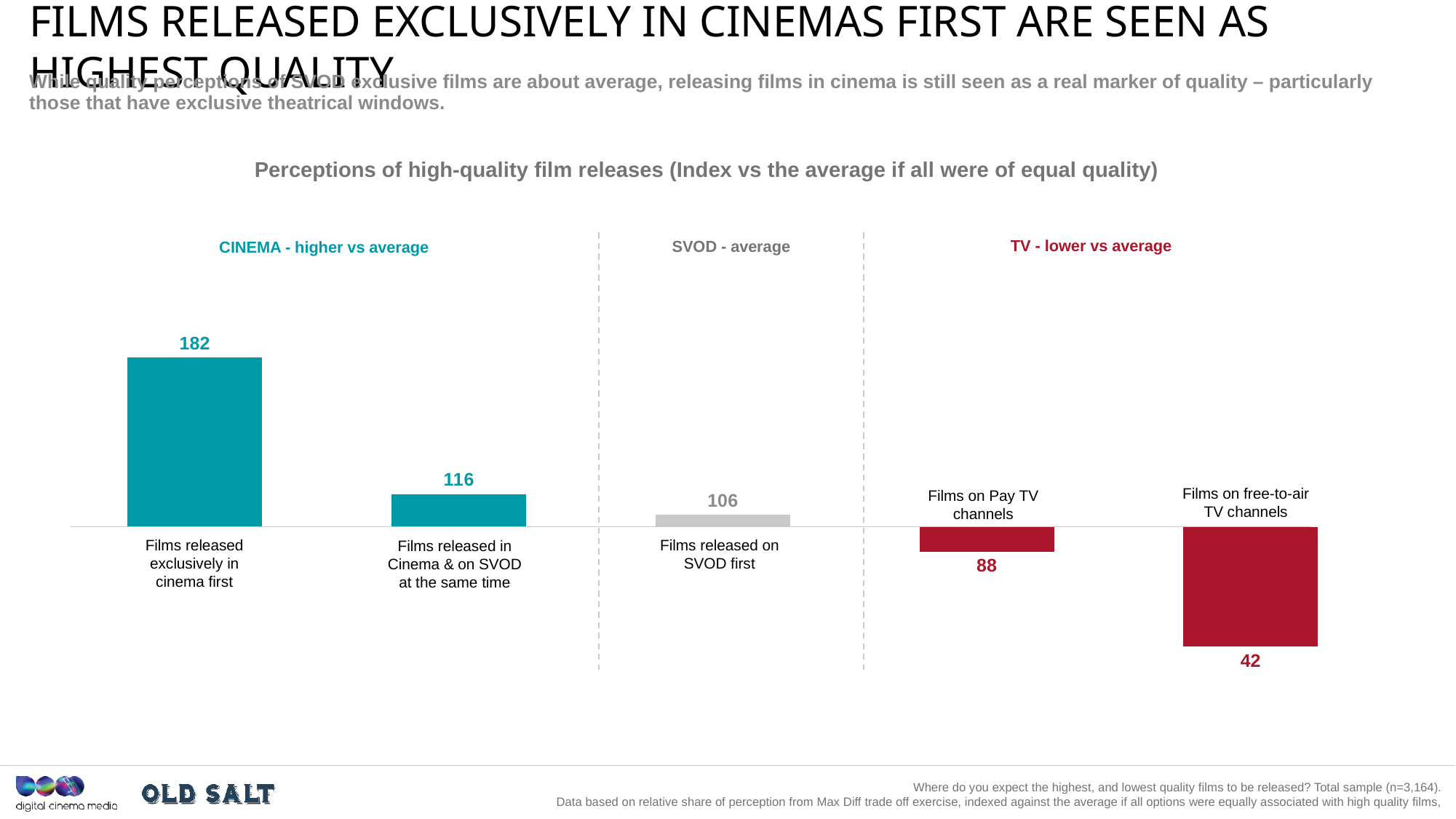
Which category has the lowest index value? Films on free-to-air TV channels Which has a higher index: films released on SVOD first or films on Pay TV channels? Films released on SVOD first What is the index value for films on Pay TV channels? 88 What type of chart is shown on the slide? Bar chart What is the difference between the index for films released exclusively in cinema first and films on free-to-air TV channels? 140 What is the index value for films released on SVOD first? 106 What is the index value for films on free-to-air TV channels? 42 What is the title of the chart? Perceptions of high-quality film releases (Index vs the average if all were of equal quality) How many categories are shown in the chart? 5 Which category has the highest index value? Films released exclusively in cinema first What is the index value for films released in Cinema & on SVOD at the same time? 116 What is the index value for films released exclusively in cinema first? 182